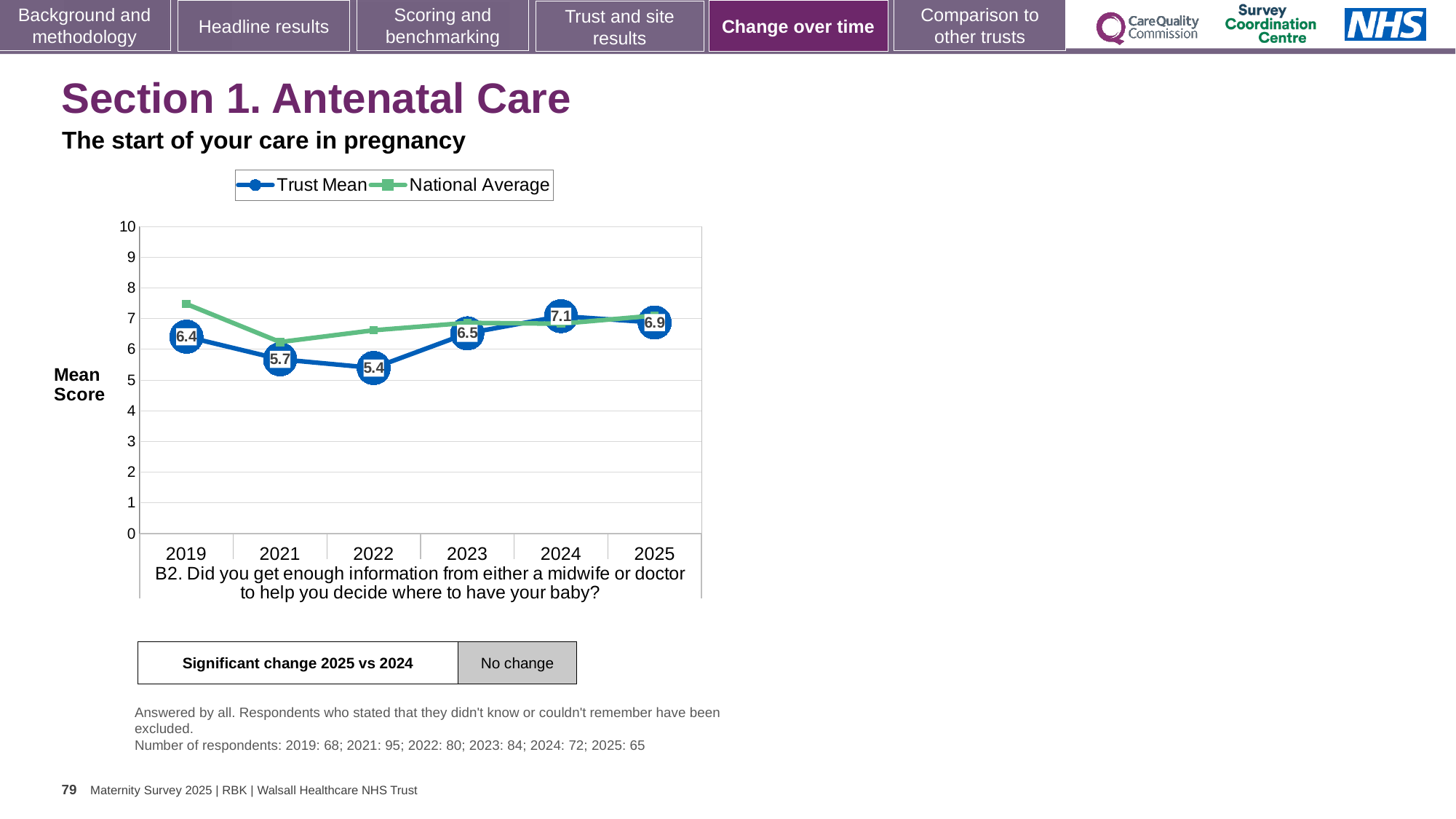
How many years are shown on the x axis? 6 What is the Trust Mean value for 2022? 5.4 In which year is the Trust Mean lowest? 2022 What is the Trust Mean value for 2019? 6.4 Is the National Average value for 2019 greater or less than 7? greater How many series does the legend list? 2 What is the difference between the Trust Mean in 2024 and in 2022? 1.7 Does the Trust Mean rise or fall from 2022 to 2024? Rise Which is larger, the Trust Mean for 2021 or for 2023? 2023 What kind of chart is shown on the slide? Line chart In which year is the Trust Mean highest? 2024 What is the Trust Mean value for 2024? 7.1